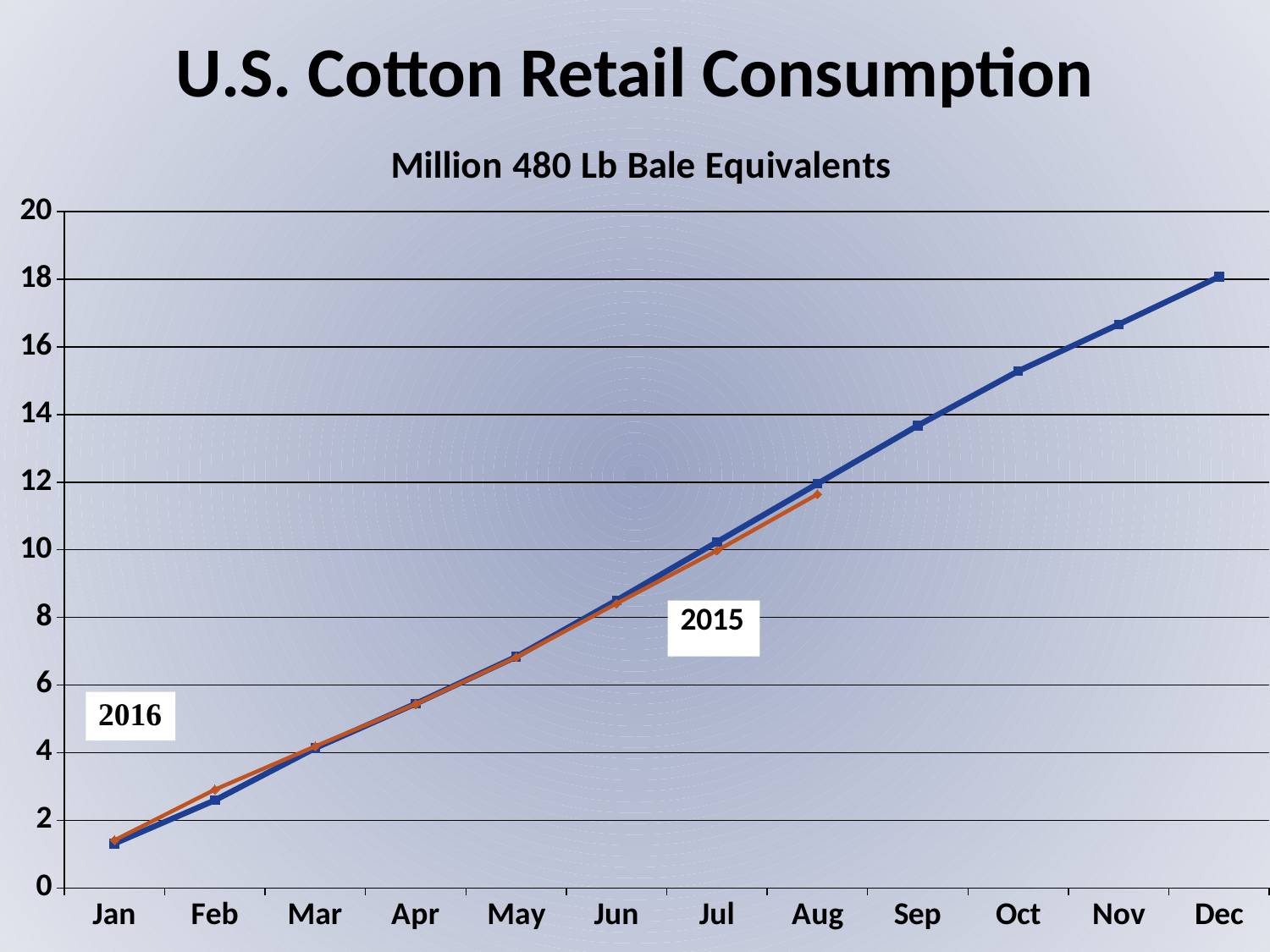
Through which month does the 2016 line extend? Aug How many months are shown on the x axis? 12 Do the values for 2015 rise or fall from Jan to Dec? rise Which month has the lowest value for 2015? Jan Which month has the highest value for 2015? Dec What kind of chart is shown on the slide? line chart In Feb, which year has the higher value, 2015 or 2016? 2016 Is the value for Dec 2015 greater or less than 16? greater Is the value for Jul 2016 greater or less than 12? less What is the title of the chart? U.S. Cotton Retail Consumption In what units are the values on the chart expressed? Million 480 Lb Bale Equivalents How many series (years) are plotted on the chart? 2